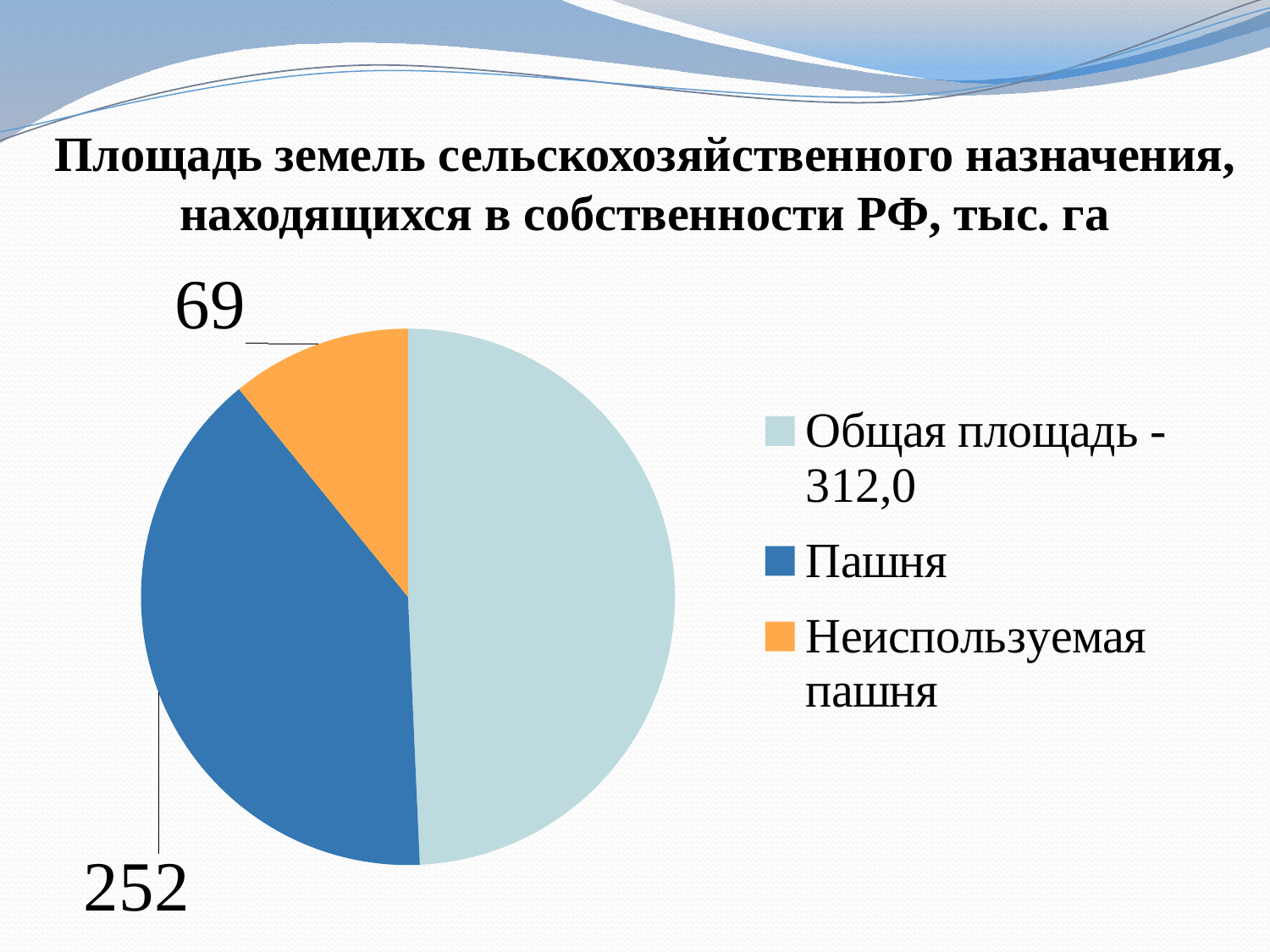
What value is labelled for the Неиспользуемая пашня slice? 69 What value is labelled for the Пашня slice? 252 What colour is the Неиспользуемая пашня slice? orange Which slice is the smallest in the pie chart? Неиспользуемая пашня What is the difference between the labelled values for Пашня and Неиспользуемая пашня? 183 Which is larger, the value for Пашня or the value for Неиспользуемая пашня? Пашня How many slices does the pie chart have? 3 What kind of chart is shown on the slide? pie chart Which slice is the largest in the pie chart? Общая площадь - 312,0 How many entries does the legend list? 3 What unit is given in the chart title? тыс. га